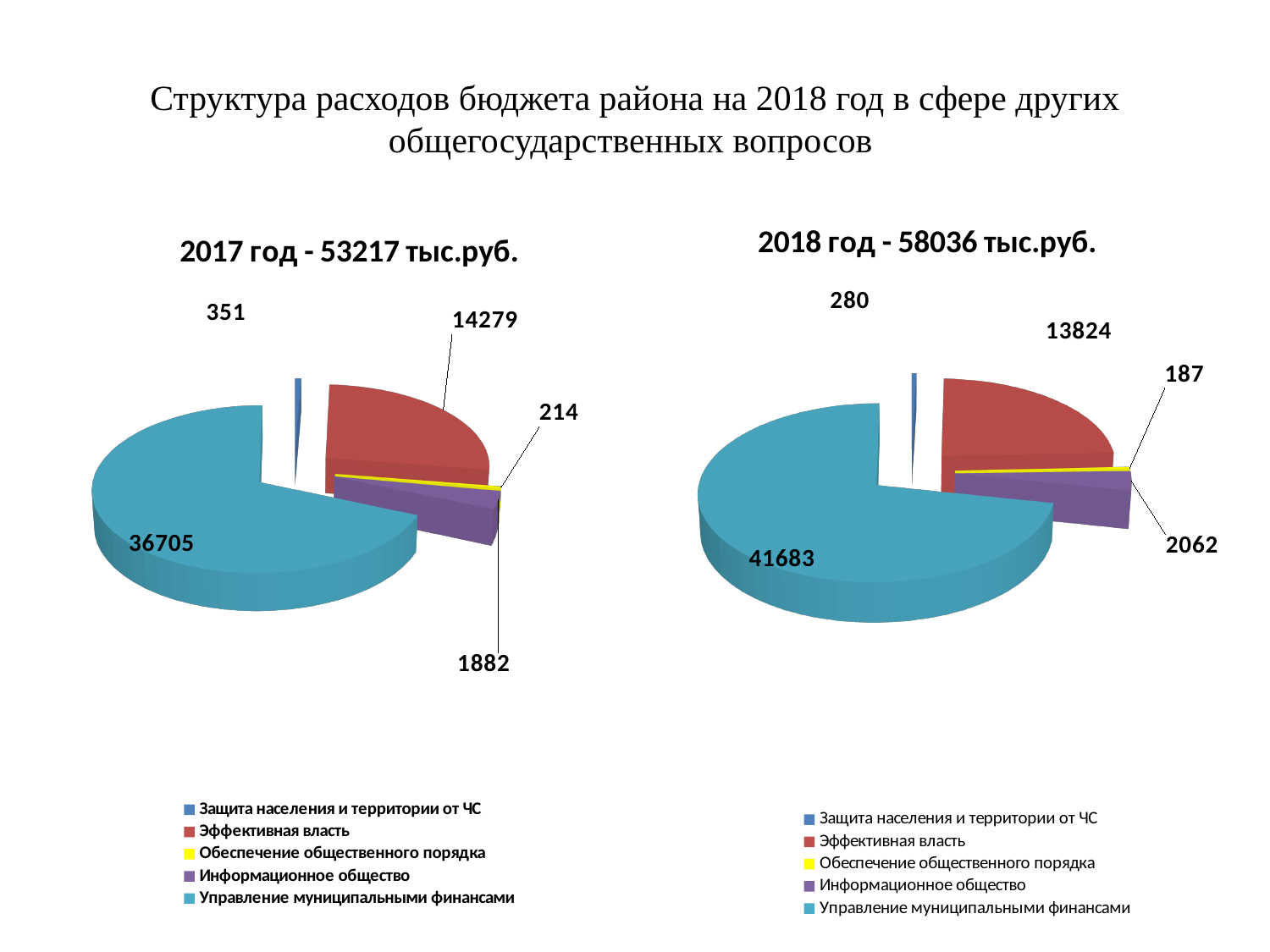
In the 2017 pie chart, what colour is the Эффективная власть slice? Red In the 2018 pie chart, what is the value for Эффективная власть? 13824 What is the difference between the Управление муниципальными финансами value in the 2018 chart and in the 2017 chart? 4978 In the 2017 pie chart, what is the value for Управление муниципальными финансами? 36705 In the 2018 pie chart, which category has the largest slice? Управление муниципальными финансами Which is larger: Эффективная власть in the 2017 chart or in the 2018 chart? 2017 chart (14279) What is the title of the right-hand chart? 2018 год - 58036 тыс.руб. What type of chart is used on this slide? Pie chart In the 2017 pie chart, which category has the smallest slice? Обеспечение общественного порядка How many categories does the 2018 pie chart show? 5 In the 2018 pie chart, what is the value for Информационное общество? 2062 In the 2017 pie chart, what is the value for Обеспечение общественного порядка? 214